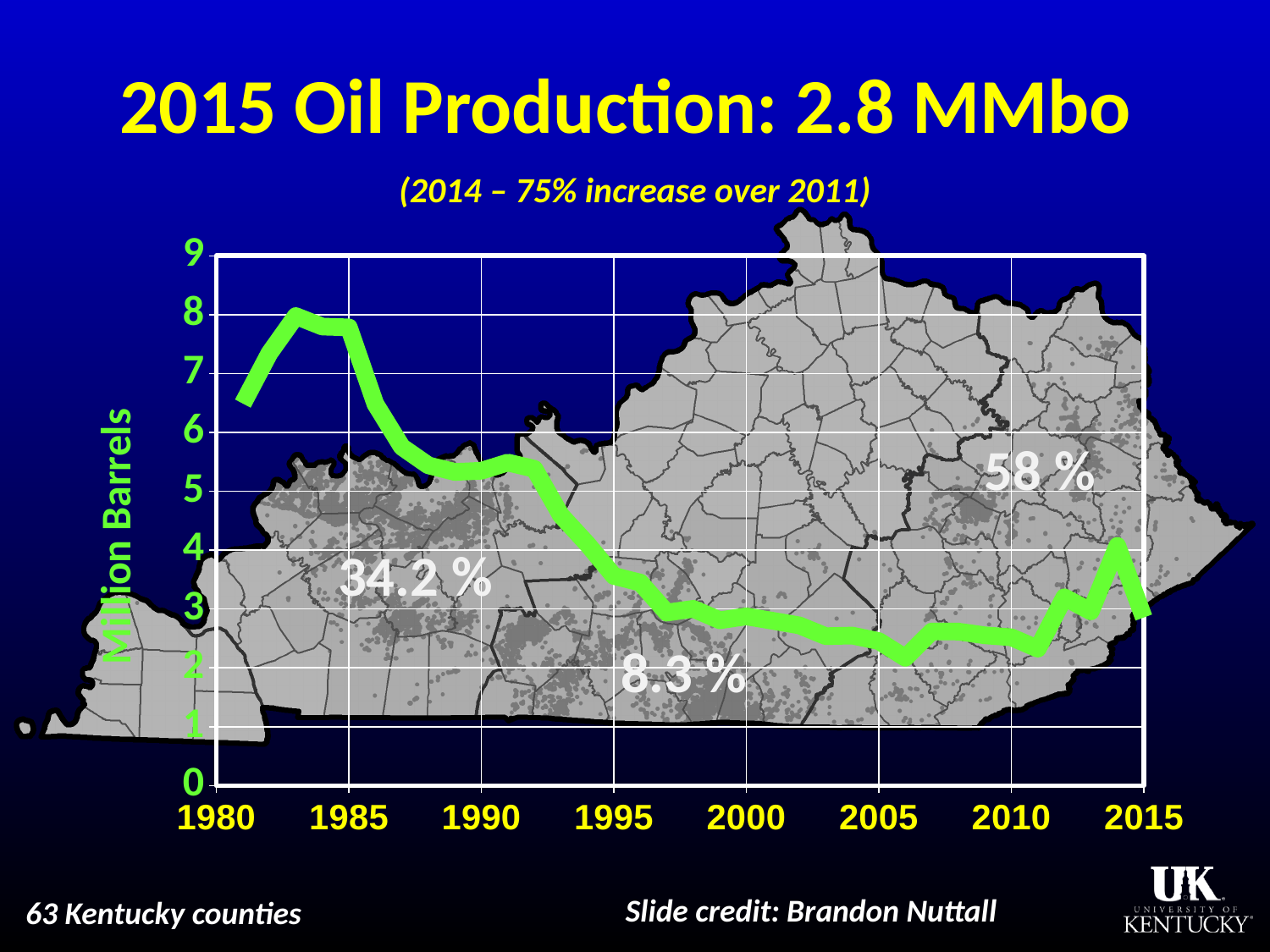
Is the value for 2000 greater or less than 4 million barrels? less Is the value for 1985 greater or less than 7 million barrels? greater What is the highest value shown on the y axis? 9 According to the slide title, what was oil production in 2015? 2.8 MMbo What kind of chart is shown on the slide? line chart What is the label on the y axis of the chart? Million Barrels Does oil production generally rise or fall between 1985 and 2005? fall Is the value for 2005 greater or less than 3 million barrels? less How many year labels are shown on the x axis? 8 What is the title of the slide's chart? 2015 Oil Production: 2.8 MMbo Which year has the higher value, 1985 or 2015? 1985